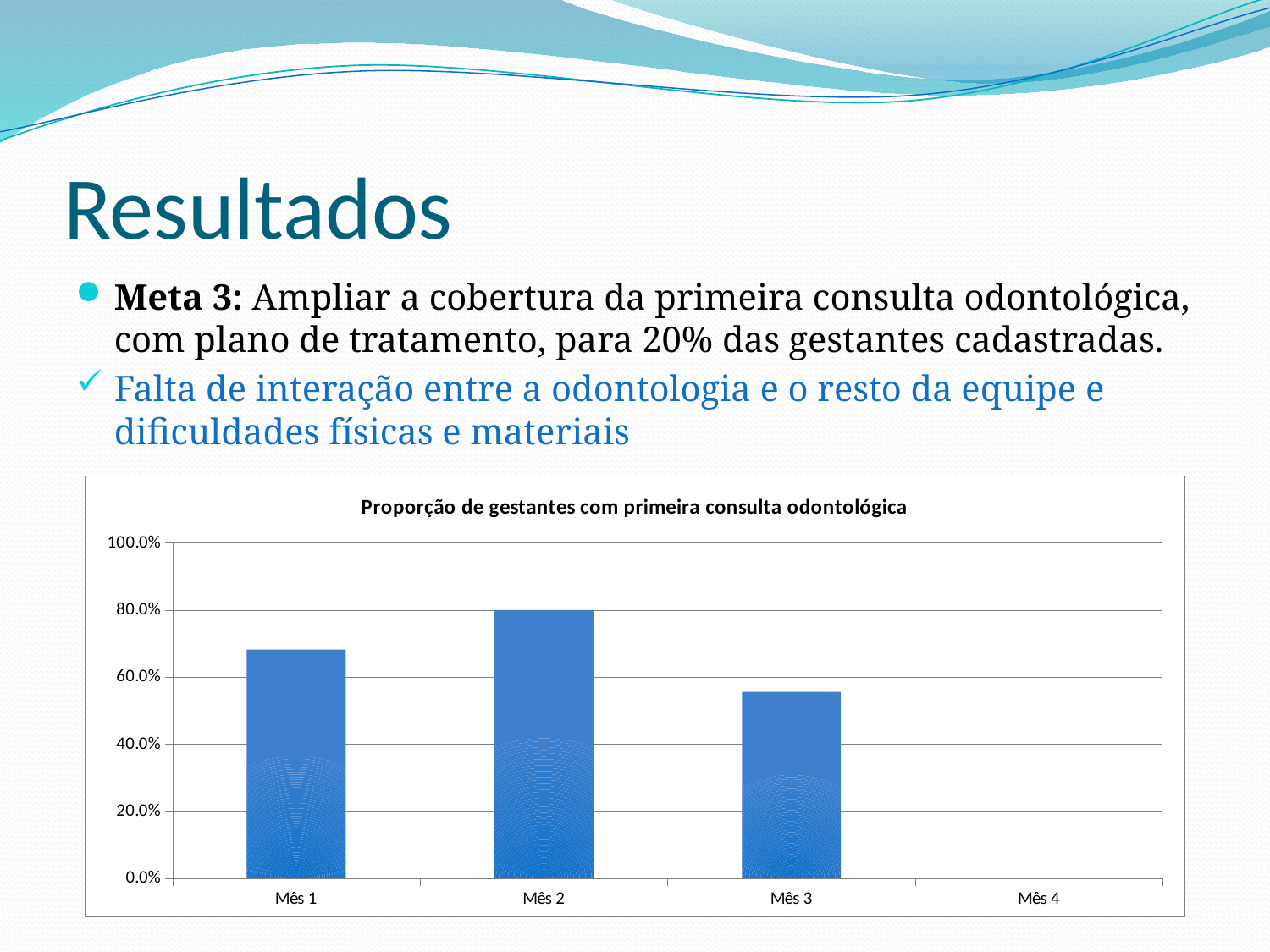
Which is larger, the value for Mês 1 or the value for Mês 3? Mês 1 How many month categories are shown on the x axis of the chart? 4 What is the title of the chart? Proporção de gestantes com primeira consulta odontológica Does the value rise or fall from Mês 2 to Mês 3? fall Which month has the highest bar in the chart? Mês 2 Is the value for Mês 3 greater or less than 40.0%? greater What is the value for Mês 2 in the chart? 80.0% Is the value for Mês 3 greater or less than 60.0%? less Which month category has no bar plotted in the chart? Mês 4 Is the value for Mês 1 greater or less than 80.0%? less What kind of chart is shown on the slide? bar chart